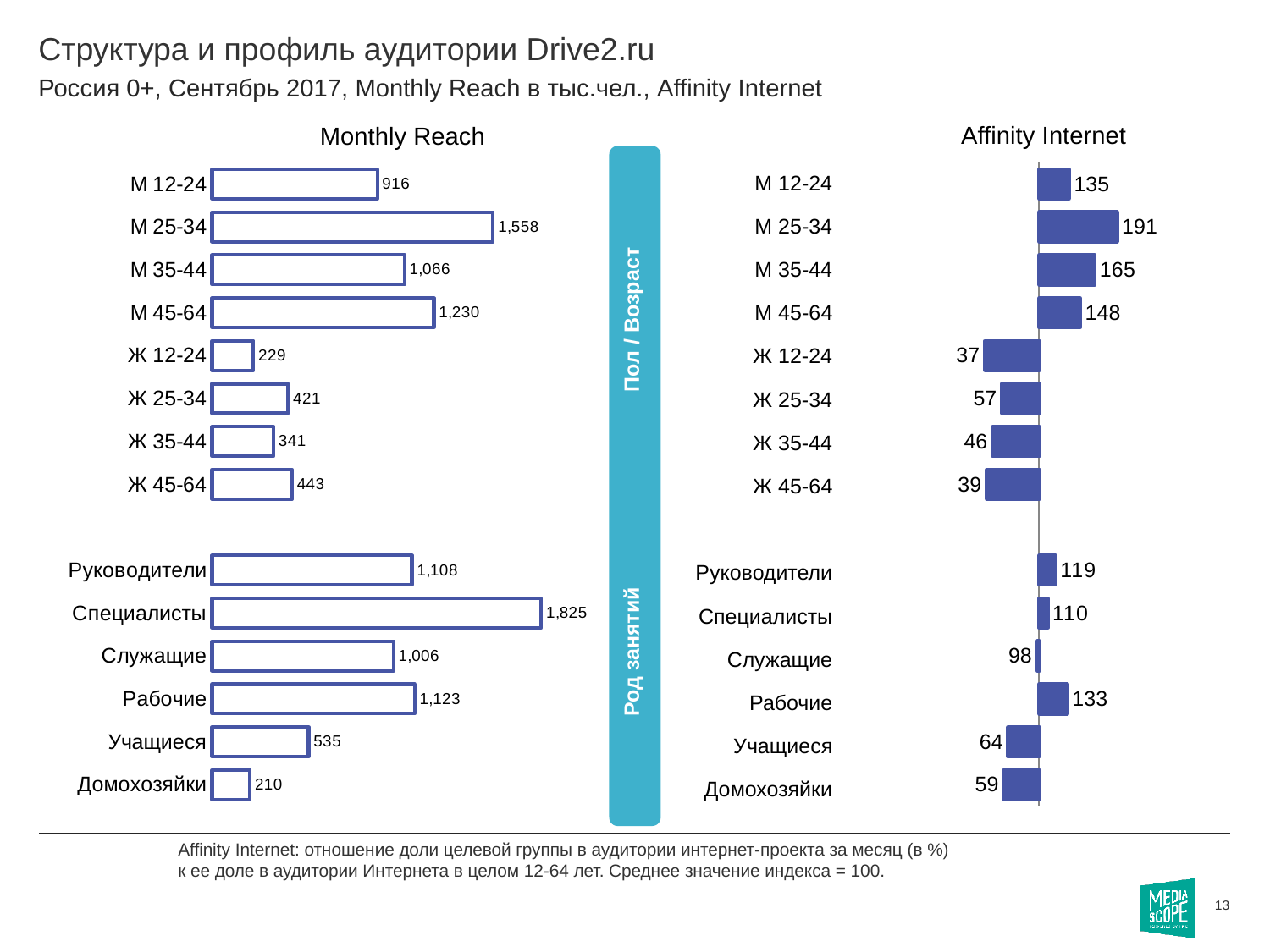
In the Monthly Reach chart, what is the difference between Специалисты and Руководители? 717 What are the two group labels shown on the vertical band between the charts? Пол / Возраст and Род занятий In the Affinity Internet chart, what is the value for Рабочие? 133 In the Monthly Reach chart, what is the value for Домохозяйки? 210 In the Affinity Internet chart, which category has the lowest value? Ж 12-24 In the Monthly Reach chart, which category has the highest value? Специалисты In the Affinity Internet chart, which is larger, М 35-44 or М 45-64? М 35-44 In the Affinity Internet chart, which category has the highest value? М 25-34 In the Affinity Internet chart, what is the difference between М 25-34 and Ж 25-34? 134 In the Monthly Reach chart, how many categories are plotted? 14 What type of chart is the Affinity Internet chart? Bar chart In the Monthly Reach chart, what is the value for М 25-34? 1,558